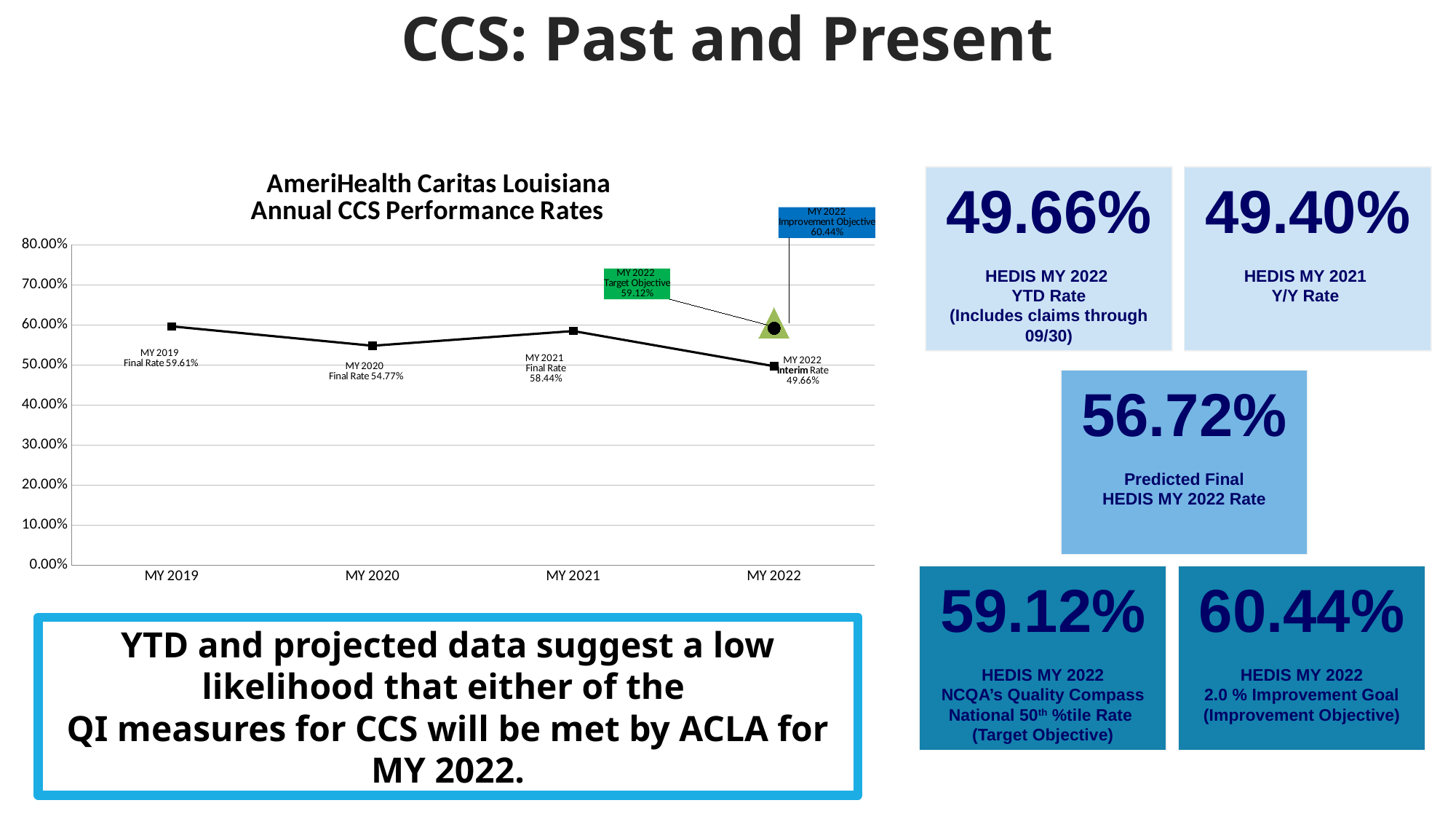
What is the MY 2022 Improvement Objective value shown on the chart? 60.44% What is the MY 2021 Final Rate shown on the chart? 58.44% How many measurement years are shown on the x axis of the chart? 4 What kind of chart is used to show the Annual CCS Performance Rates? Line chart What is the difference between the MY 2019 Final Rate and the MY 2020 Final Rate? 4.84% What is the MY 2019 Final Rate shown on the chart? 59.61% What is the MY 2022 Interim Rate shown on the chart? 49.66% Which is larger, the MY 2021 Final Rate or the MY 2022 Interim Rate? MY 2021 Final Rate Which measurement year has the lowest rate on the chart? MY 2022 Which measurement year has the highest final/interim rate on the chart? MY 2019 What is the MY 2020 Final Rate shown on the chart? 54.77% What is the MY 2022 Target Objective value shown on the chart? 59.12%